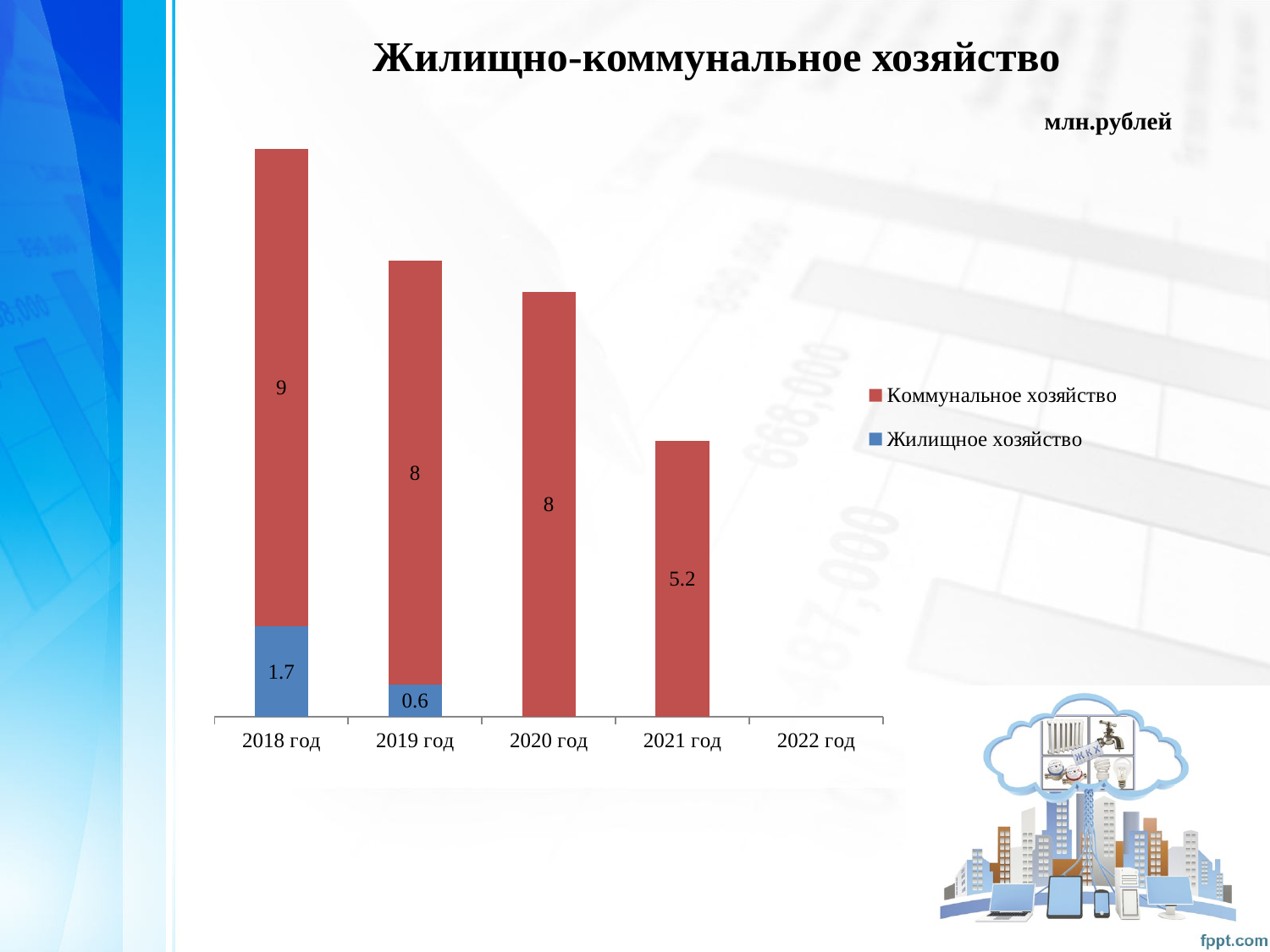
What is the value for Жилищное хозяйство in 2019 год? 0.6 What is the value for Коммунальное хозяйство in 2018 год? 9 What is the difference between the Коммунальное хозяйство values for 2018 год and 2021 год? 3.8 Which is larger: Жилищное хозяйство in 2018 год or in 2019 год? 2018 год What is the total of the stacked bar for 2018 год? 10.7 Which year with a plotted bar has the lowest value for Коммунальное хозяйство? 2021 год What is the value for Коммунальное хозяйство in 2021 год? 5.2 Do the Коммунальное хозяйство values rise or fall from 2018 год to 2021 год? Fall Which year has the highest value for Коммунальное хозяйство? 2018 год How many series does the legend list? 2 What kind of chart is shown on the slide? Stacked bar chart What is the total of the stacked bar for 2019 год? 8.6